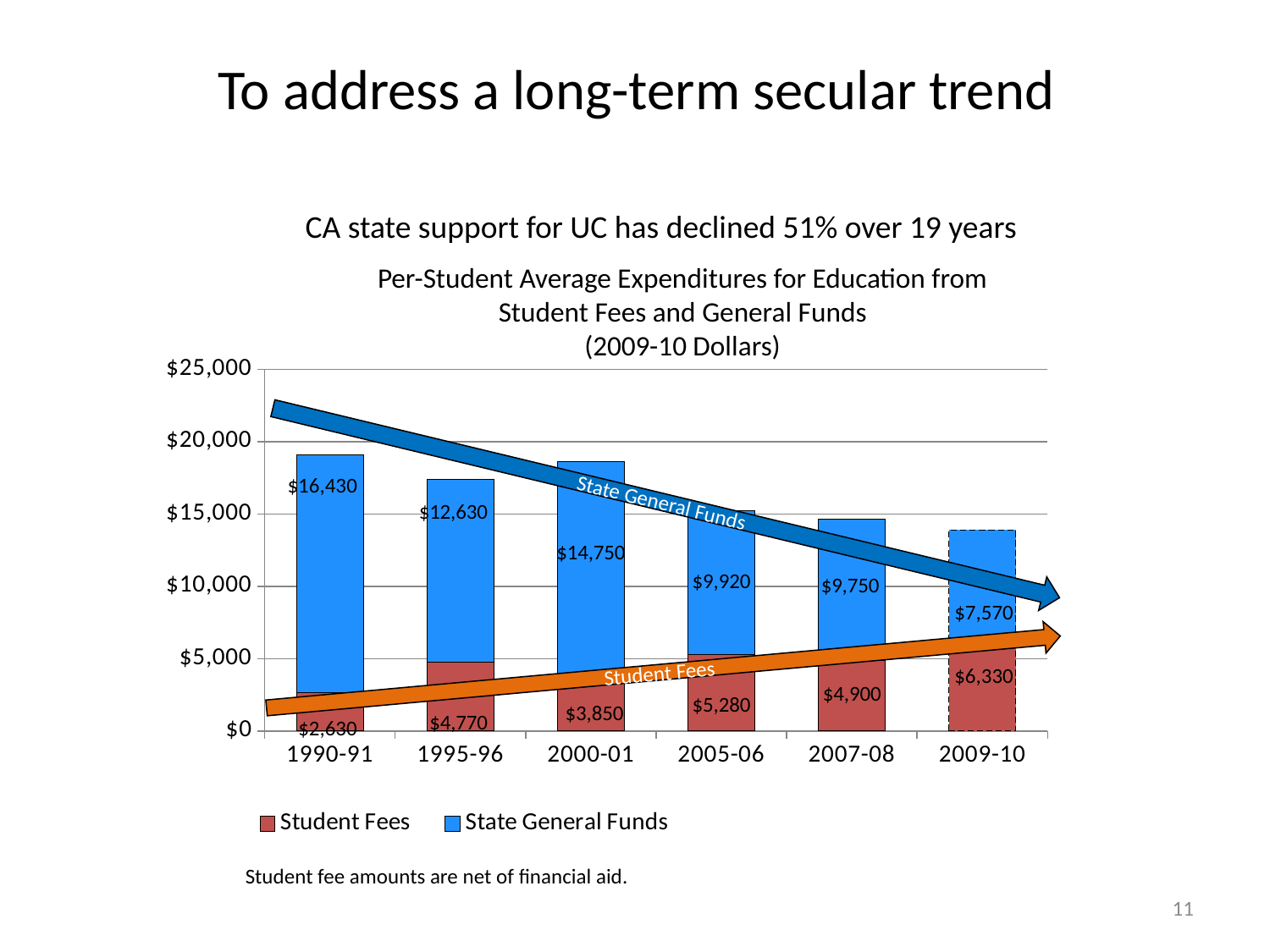
Which year has the lowest State General Funds value? 2009-10 What is the Student Fees value for 2009-10? $6,330 What is the total of the stacked bar for 2009-10? $13,900 Which is larger, the Student Fees value for 1995-96 or for 2000-01? 1995-96 Which year has the highest Student Fees value? 2009-10 How many year categories are shown on the x axis? 6 What kind of chart is shown on the slide? Stacked bar chart What is the State General Funds value for 2005-06? $9,920 What is the State General Funds value for 1990-91? $16,430 What is the difference between the State General Funds values for 1990-91 and 2009-10? $8,860 How many series does the legend list? 2 Do the State General Funds values generally rise or fall from 1990-91 to 2009-10? Fall